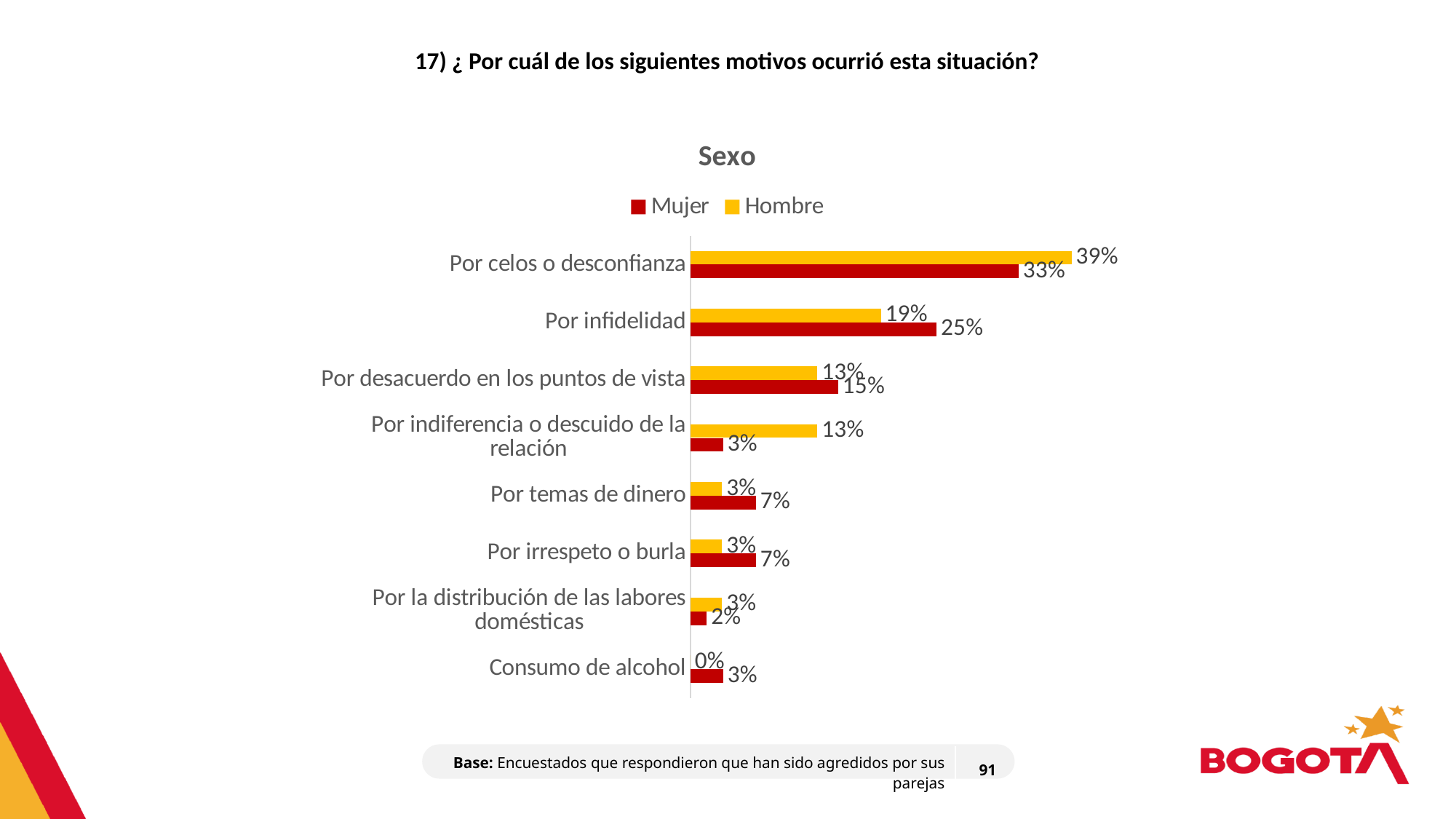
What is the Hombre value for 'Por celos o desconfianza'? 39% What is the Mujer value for 'Por infidelidad'? 25% How many series does the legend list? 2 Which category has the lowest Hombre value? Consumo de alcohol What is the difference between the Hombre and Mujer values for 'Por celos o desconfianza'? 6% What kind of chart is shown on the slide? Bar chart Which category has the highest Mujer value? Por celos o desconfianza What is the Hombre value for 'Consumo de alcohol'? 0% For 'Por indiferencia o descuido de la relación', which is larger, the Hombre value or the Mujer value? Hombre Which colour represents the Mujer series in the chart? Red How many categories (motivos) are shown in the chart? 8 What is the Mujer value for 'Por indiferencia o descuido de la relación'? 3%